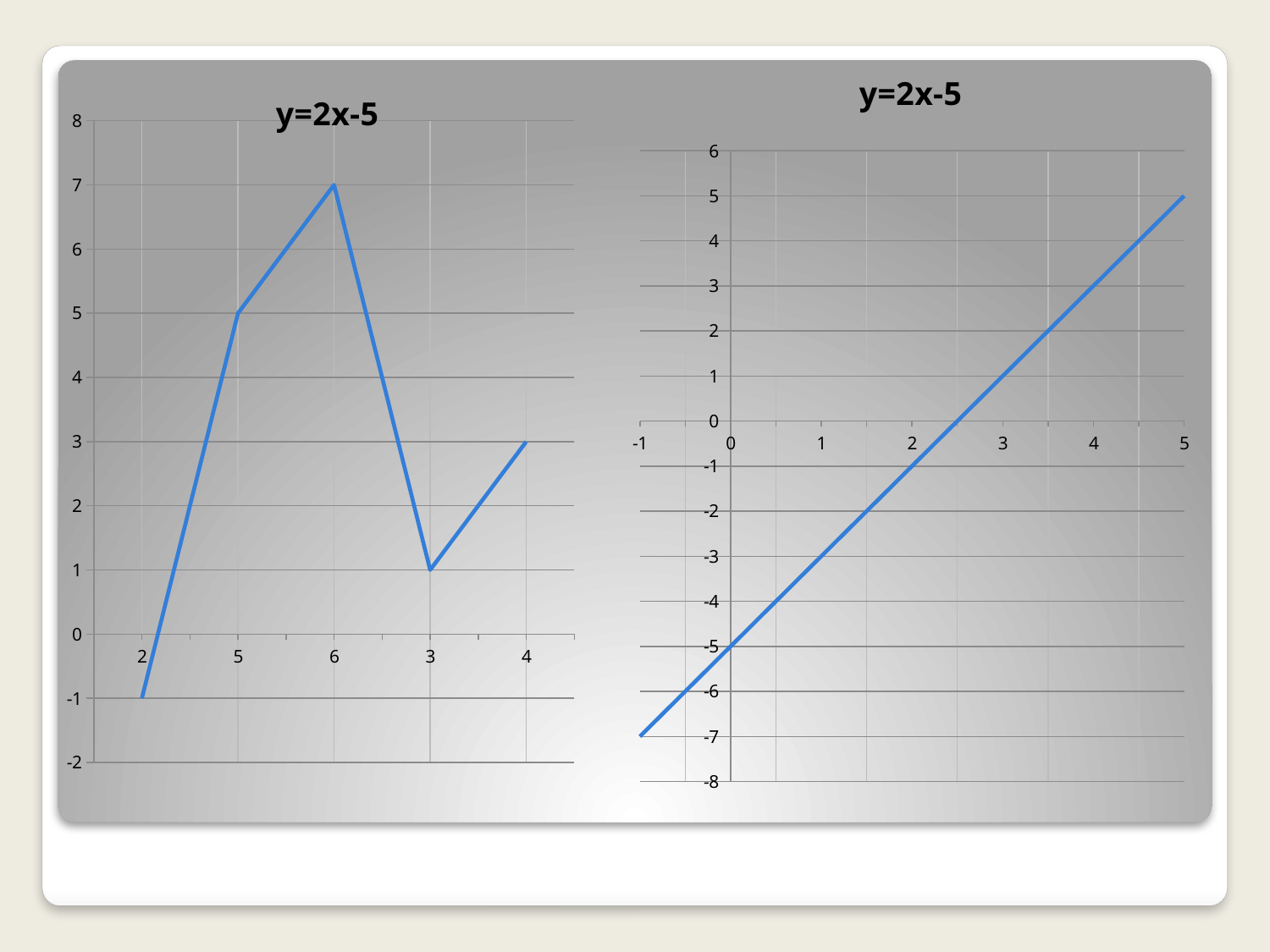
In the chart on the left, which has the larger value: category 5 or category 4? 5 In the chart on the right, what is the y value of the line at x = 0? -5 In the chart on the right, what is the y value of the line at x = 5? 5 In the chart on the left, how many data points are plotted? 5 In the chart on the left, which x-axis category has the highest value? 6 What is the title shown on both charts? y=2x-5 In the chart on the right, does the line rise or fall as x increases? rise In the chart on the left, which x-axis category has the lowest value? 2 What kind of chart is the chart on the left of the slide? line chart In the chart on the left, what is the value at x-axis category 5? 5 In the chart on the left, what is the difference between the value at category 6 and the value at category 3? 6 In the chart on the left, what is the value at x-axis category 3? 1